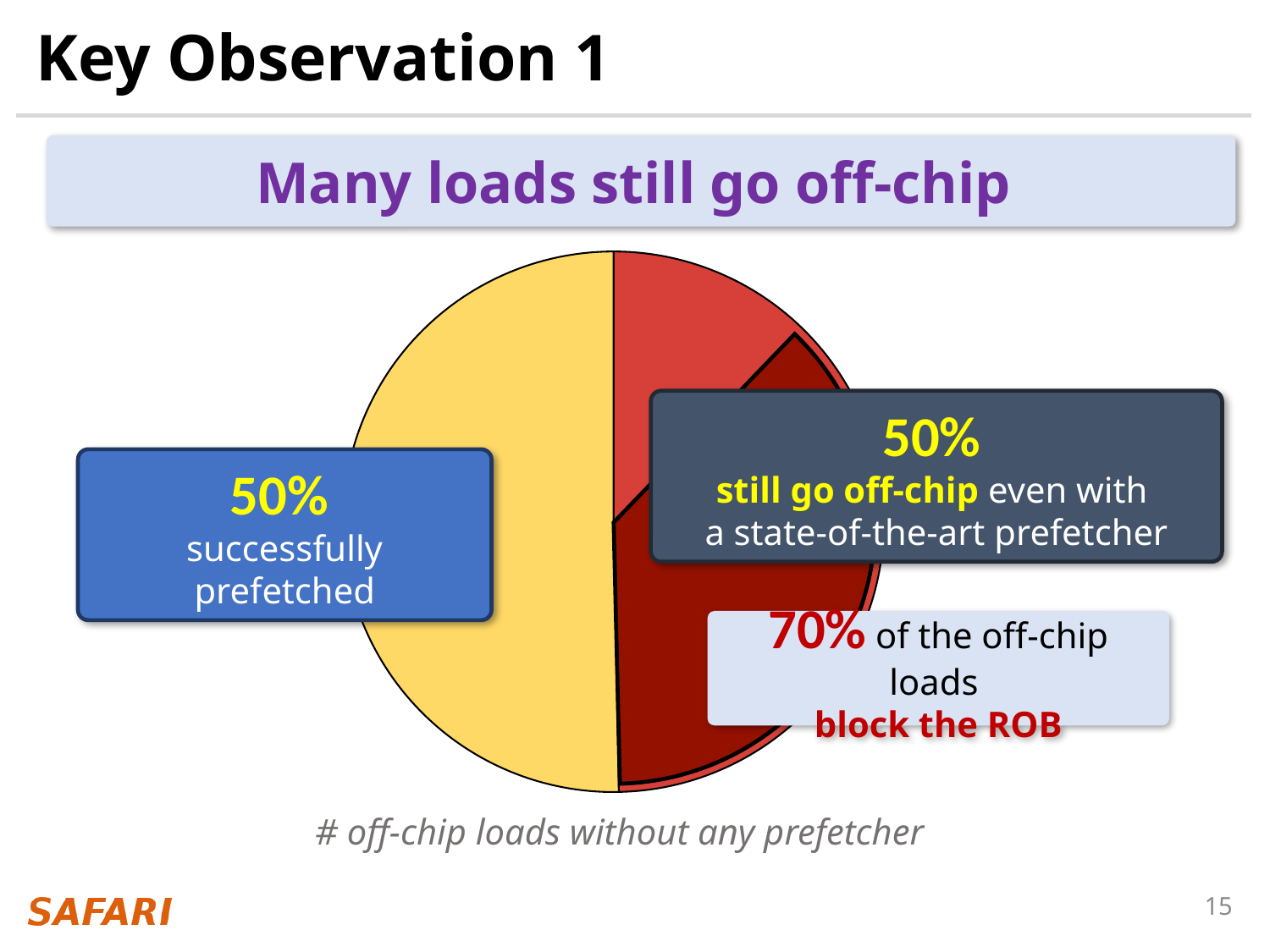
What is the combined share of the 'successfully prefetched' and 'still go off-chip' slices? 100% What share of loads still go off-chip even with a state-of-the-art prefetcher? 50% Which colour is the slice labelled 'successfully prefetched'? yellow What does the caption below the pie chart say the chart represents? # off-chip loads without any prefetcher What kind of chart is shown on the slide? pie chart Is the share of loads that are successfully prefetched larger or smaller than the share that still go off-chip? equal What share of off-chip loads is labelled as successfully prefetched? 50% What is the title shown in the box above the pie chart? Many loads still go off-chip Is the share of off-chip loads that block the ROB greater or less than 50%? greater What is the difference between the share successfully prefetched and the share that still go off-chip? 0% What percentage of the off-chip loads block the ROB, according to the label? 70%